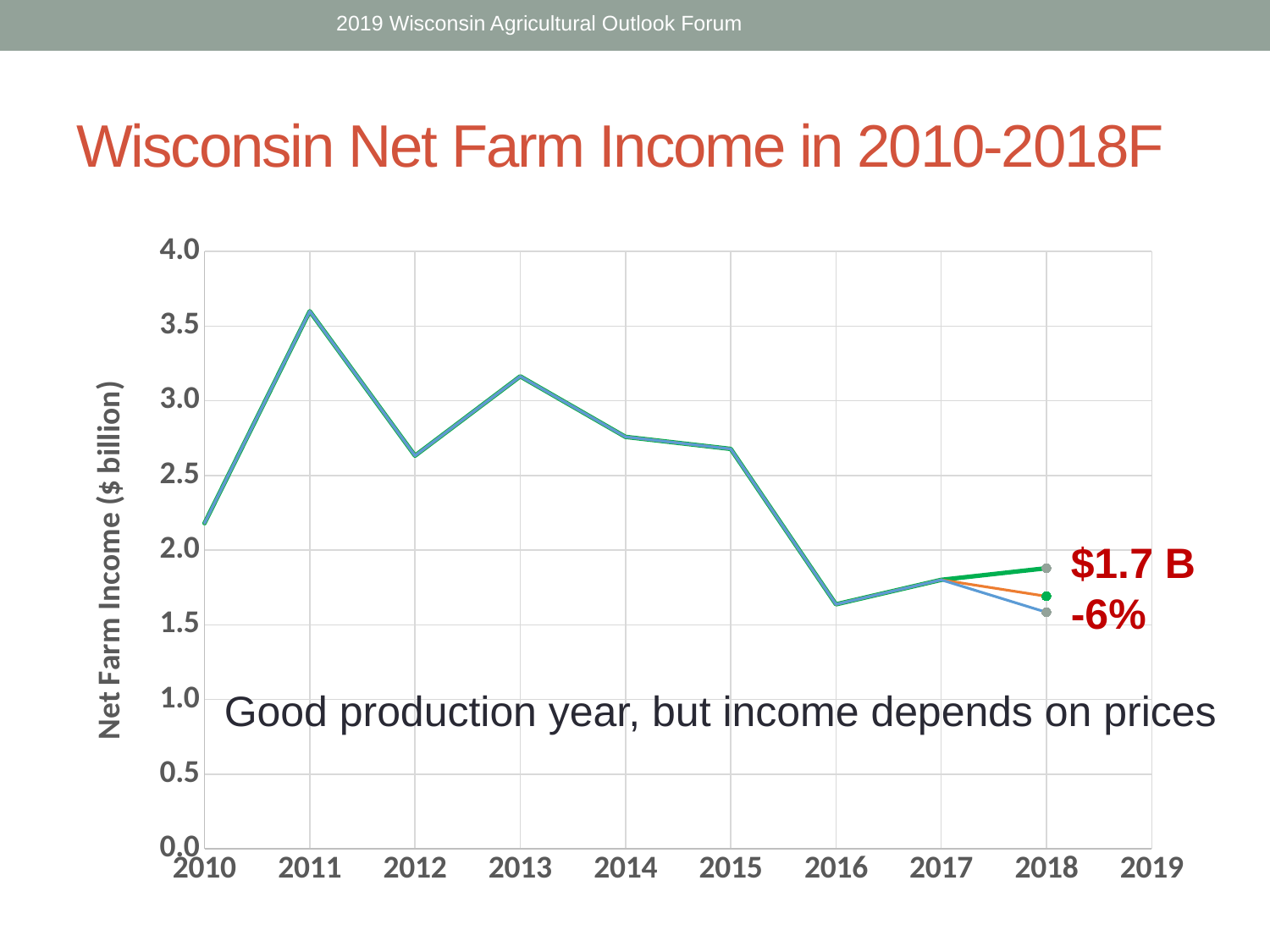
Is the net farm income for 2016 greater or less than 2.0? less What percentage change is labelled next to the 2018 forecast? -6% Which year has higher net farm income, 2011 or 2013? 2011 What net farm income value is labelled for the 2018 forecast? $1.7 B What is the title of the chart on the slide? Wisconsin Net Farm Income in 2010-2018F What is the label on the vertical axis of the chart? Net Farm Income ($ billion) In which year is Wisconsin net farm income highest? 2011 Is the net farm income for 2011 greater or less than 3.0? greater Does net farm income rise or fall from 2013 to 2016? fall What kind of chart is shown on the slide? line chart Is the net farm income for 2010 greater or less than 2.5? less Between 2010 and 2017, in which year is net farm income lowest? 2016